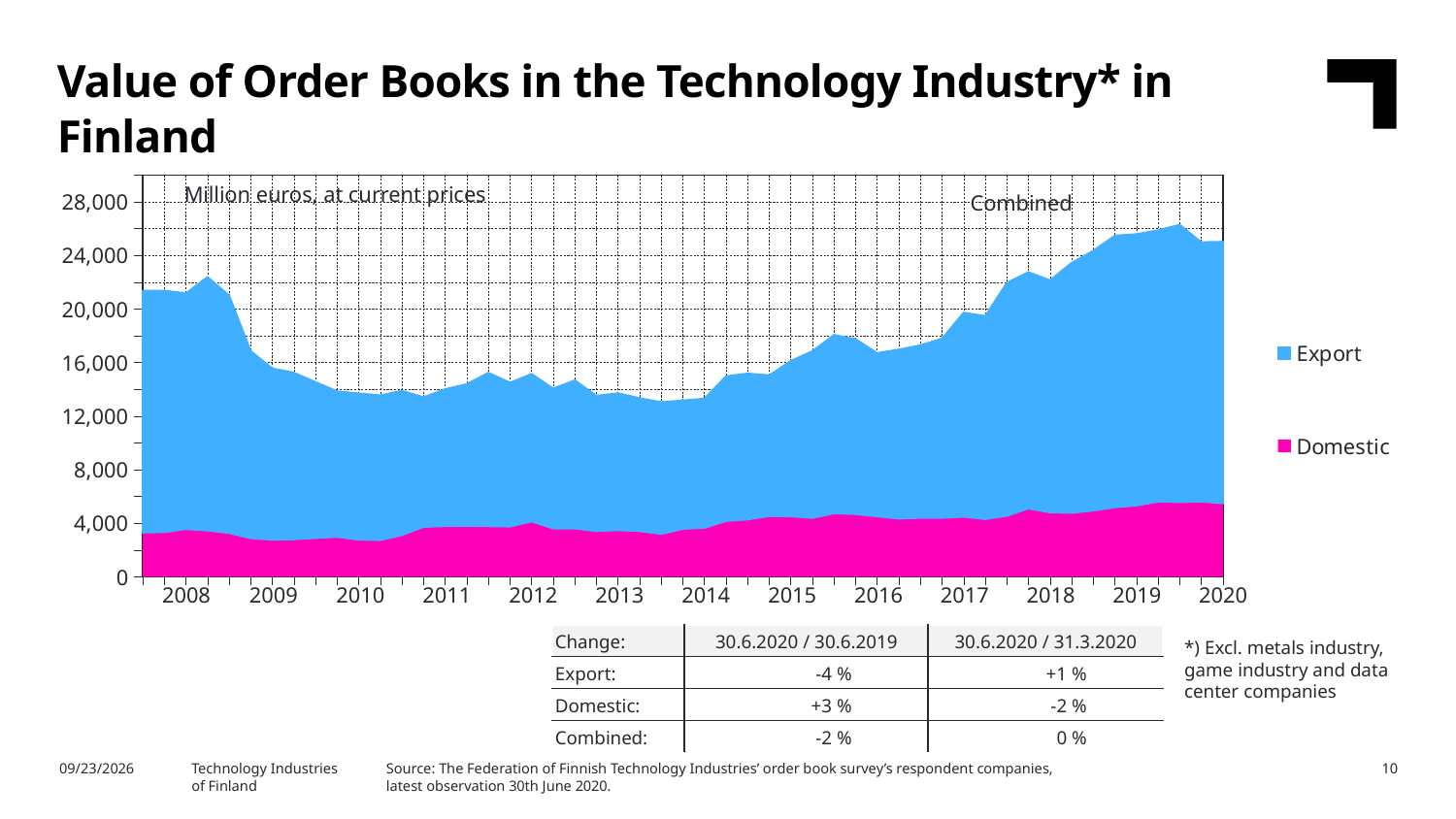
How many years are labelled on the x axis? 13 Does the combined value of order books rise or fall between 2017 and 2019? rise Is the combined value of order books in 2010 greater or less than 16,000? less What kind of chart is shown on the slide? Stacked area chart Is the Domestic value in 2020 greater or less than 4,000? greater How many series does the legend list? 2 Which two series are listed in the chart legend? Export and Domestic Does the combined value of order books rise or fall between 2008 and 2009? fall In what unit are the values on the chart expressed, according to the label inside the plot area? Million euros, at current prices Is the combined value of order books in 2013 greater or less than 16,000? less